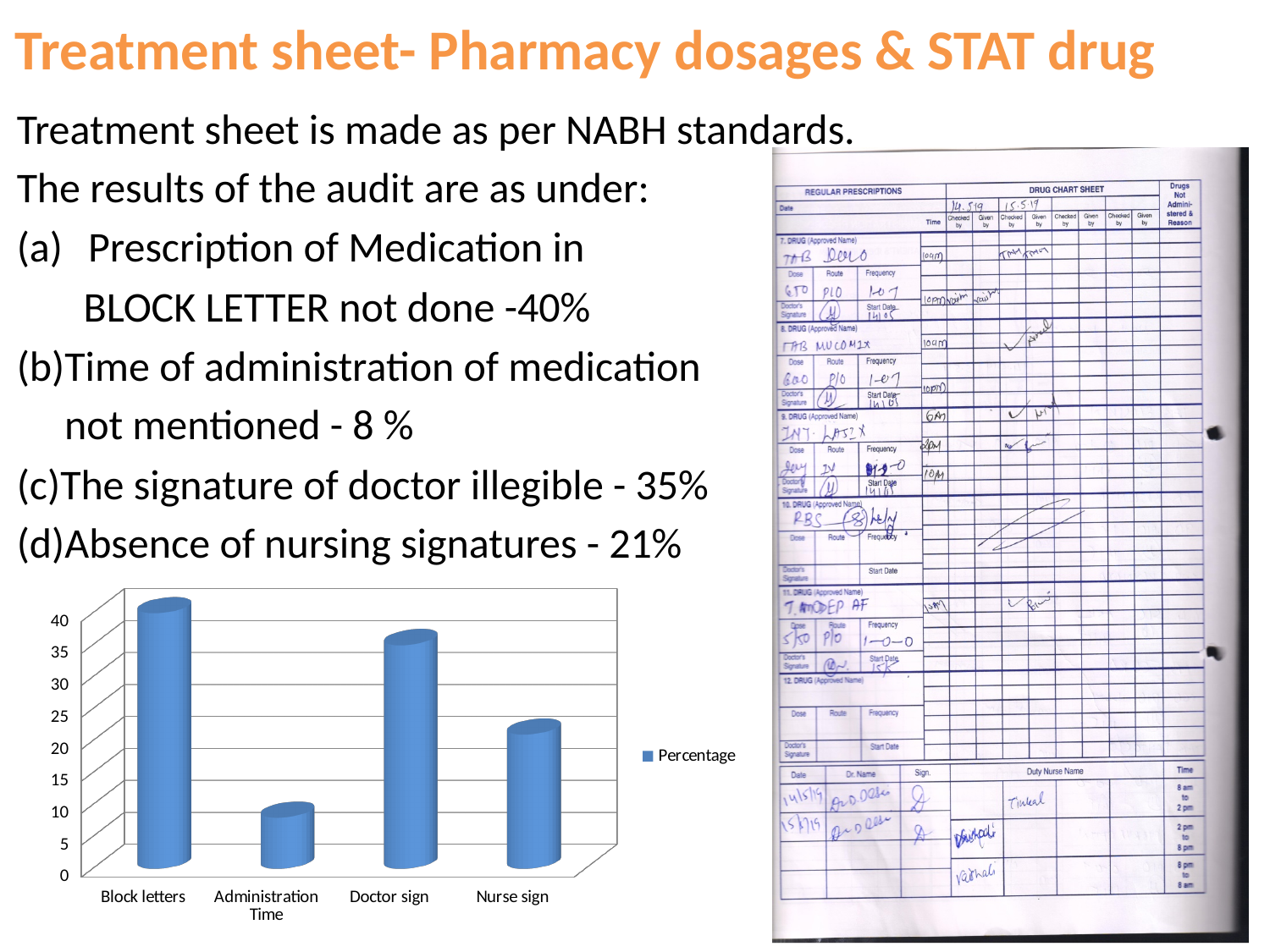
Is the value for Administration Time greater or less than 10? less What is the name of the series shown in the chart legend? Percentage What is the value for Doctor sign in the chart? 35 Which category has the highest bar in the chart? Block letters What kind of chart is shown on the slide? bar chart Which category has the lowest bar in the chart? Administration Time Is the value for Nurse sign greater or less than 20? greater How many categories are shown on the x axis of the chart? 4 Which is larger in the chart, the value for Doctor sign or the value for Nurse sign? Doctor sign What is the value for Block letters in the chart? 40 What is the difference between the value for Block letters and the value for Doctor sign? 5 How many series does the chart legend list? 1